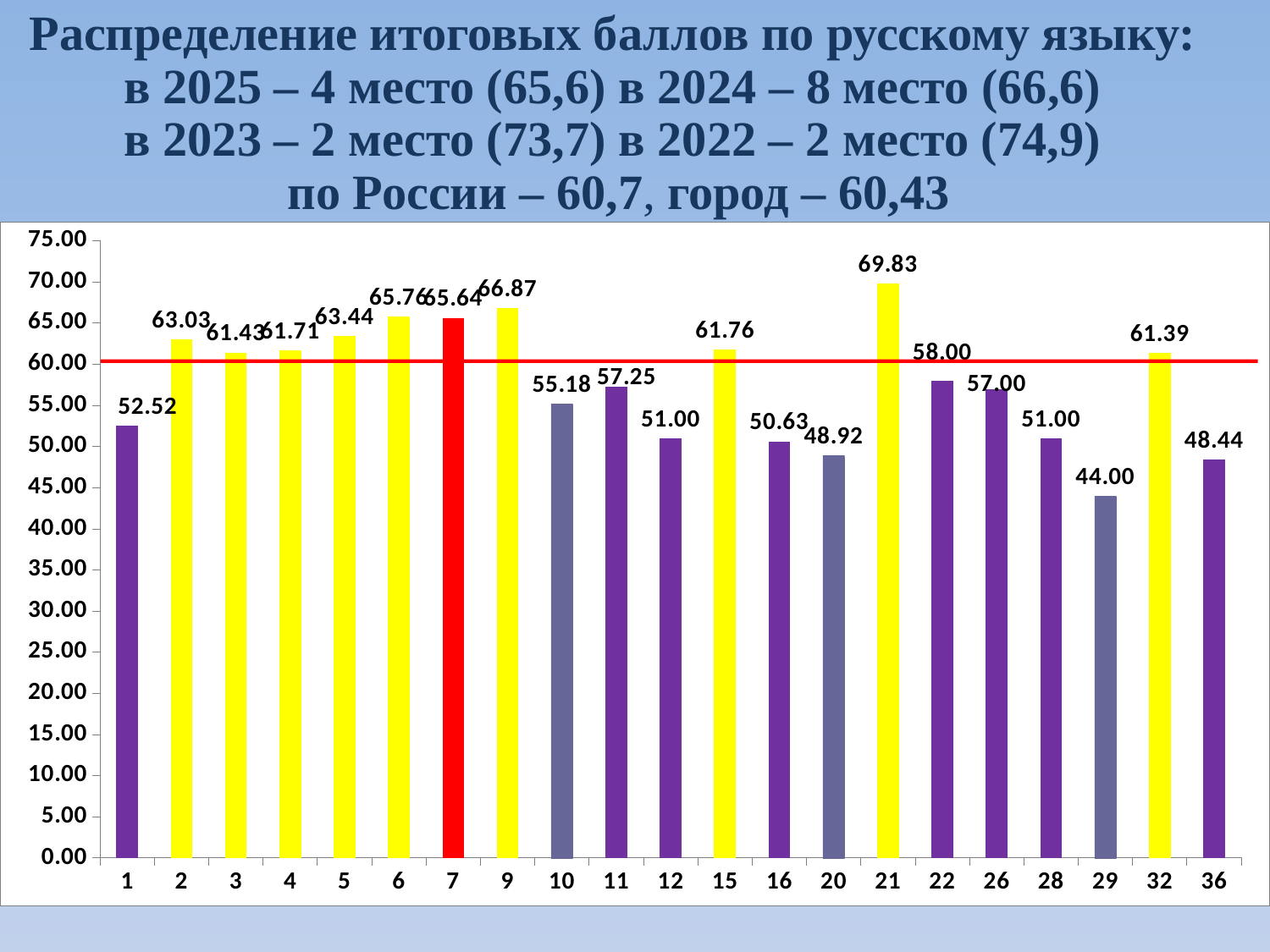
Which category has the lowest value? 29 What kind of chart is shown on the slide? bar chart Is the value for category 22 greater or less than 60.00? less What is the value for category 21? 69.83 What is the value for category 32? 61.39 What is the difference between the values for category 21 and category 29? 25.83 Which is larger, the value for category 9 or the value for category 10? category 9 Which category has the highest value? 21 What is the value for category 29? 44.00 How many bars are shown in the chart? 21 What is the value for category 1? 52.52 Which category's bar is coloured red? 7